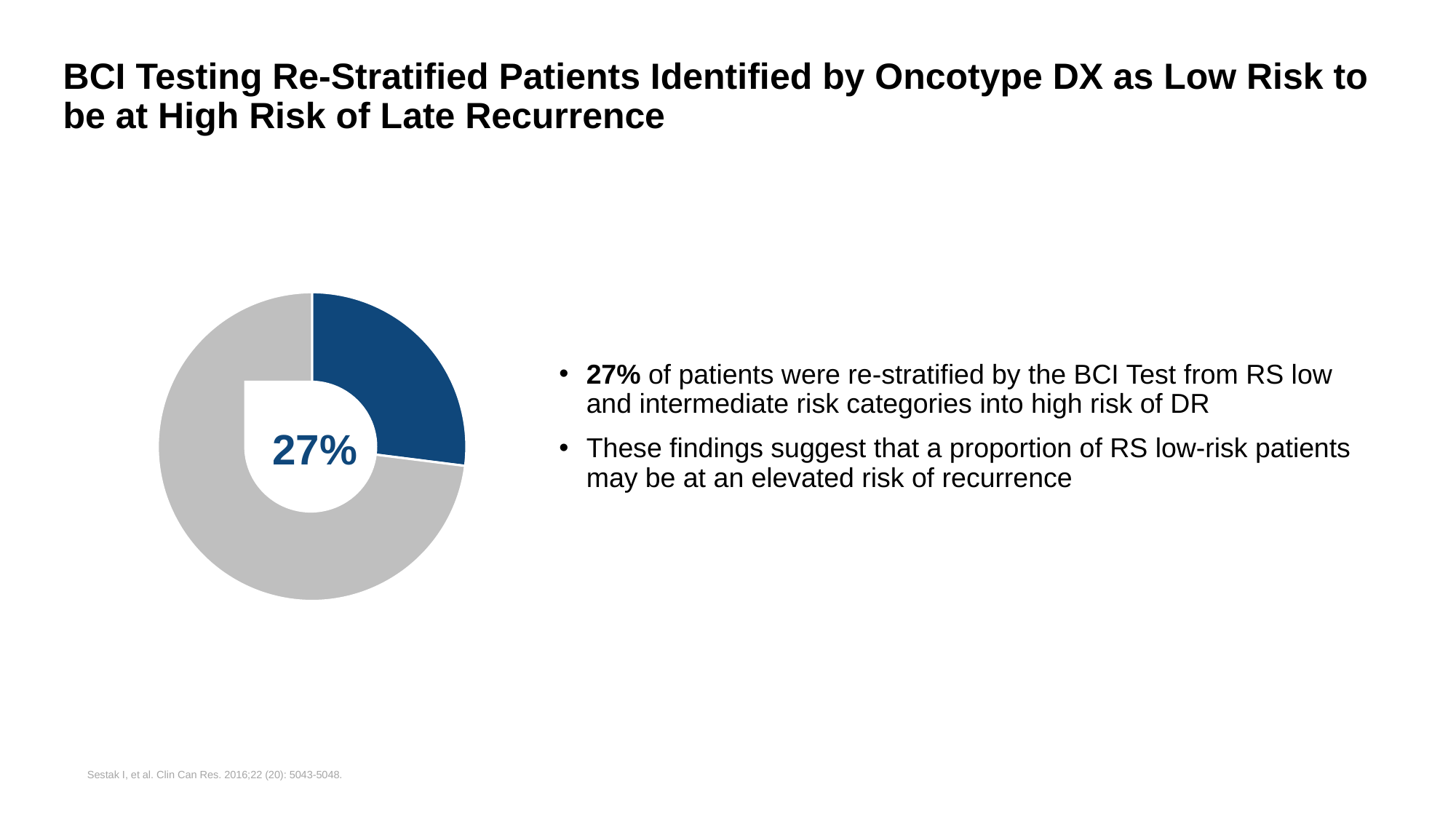
What kind of chart is shown on the slide? Donut chart How many slices does the donut chart have? 2 What colour is the slice of the donut chart that represents 27%? Blue Which slice of the donut chart is larger, the blue one or the grey one? Grey What share of the donut chart does the blue slice represent? 27% Does the donut chart have a legend? No Is the blue slice of the donut chart greater or less than 50% of the whole? less What percentage is printed in the centre of the donut chart? 27%